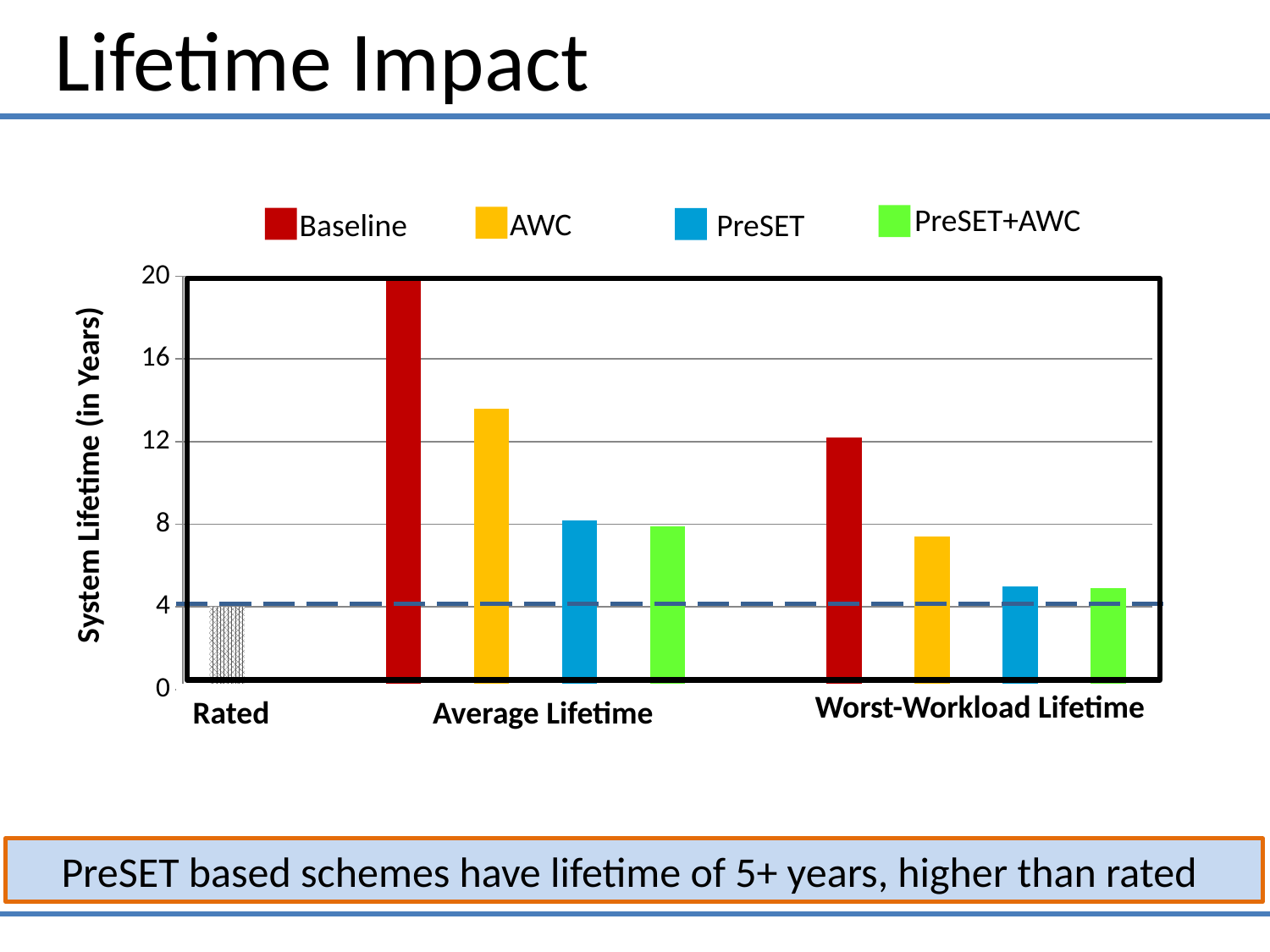
Is the Baseline value for Average Lifetime greater or less than 16? greater Which is larger, the Baseline value for Average Lifetime or the Baseline value for Worst-Workload Lifetime? Average Lifetime Within the Average Lifetime category, do the bars rise or fall going from Baseline to PreSET+AWC? fall Is the AWC value for Average Lifetime greater or less than 12? greater How many categories are shown on the x axis? 3 What is the title of the y axis? System Lifetime (in Years) What kind of chart is shown on the slide? bar chart Which series has the highest bar in the Worst-Workload Lifetime category? Baseline Which series is shown in red in the legend? Baseline Is the AWC value for Worst-Workload Lifetime greater or less than 8? less How many series does the legend list? 4